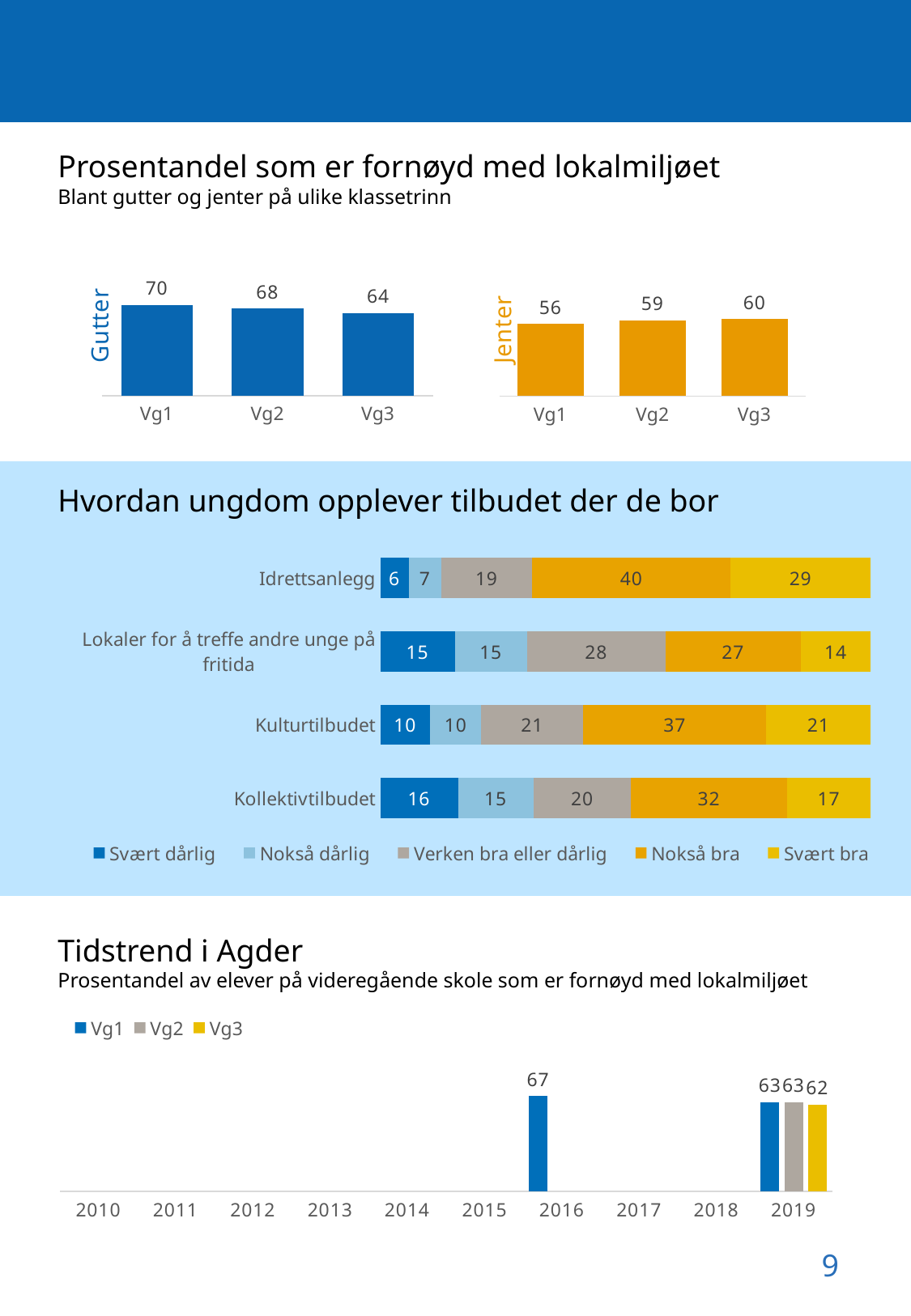
In the 'Tidstrend i Agder' chart, what is the Vg1 value for 2016? 67 In the chart 'Hvordan ungdom opplever tilbudet der de bor', which category has the largest 'Svært bra' value? Idrettsanlegg What kind of chart is the 'Tidstrend i Agder' chart? bar chart In the Jenter chart, what is the value for Vg3? 60 In the chart 'Hvordan ungdom opplever tilbudet der de bor', how many series does the legend list? 5 In the chart 'Hvordan ungdom opplever tilbudet der de bor', what is the 'Nokså bra' value for Kulturtilbudet? 37 In the Gutter chart, what is the value for Vg1? 70 In the chart 'Hvordan ungdom opplever tilbudet der de bor', what is the total of the Kollektivtilbudet bar? 100 In the Gutter chart, what is the difference between Vg1 and Vg3? 6 In the Jenter chart, which category has the highest value? Vg3 In the Gutter chart, do the values rise or fall from Vg1 to Vg3? fall In the Gutter chart, which category has the lowest value? Vg3